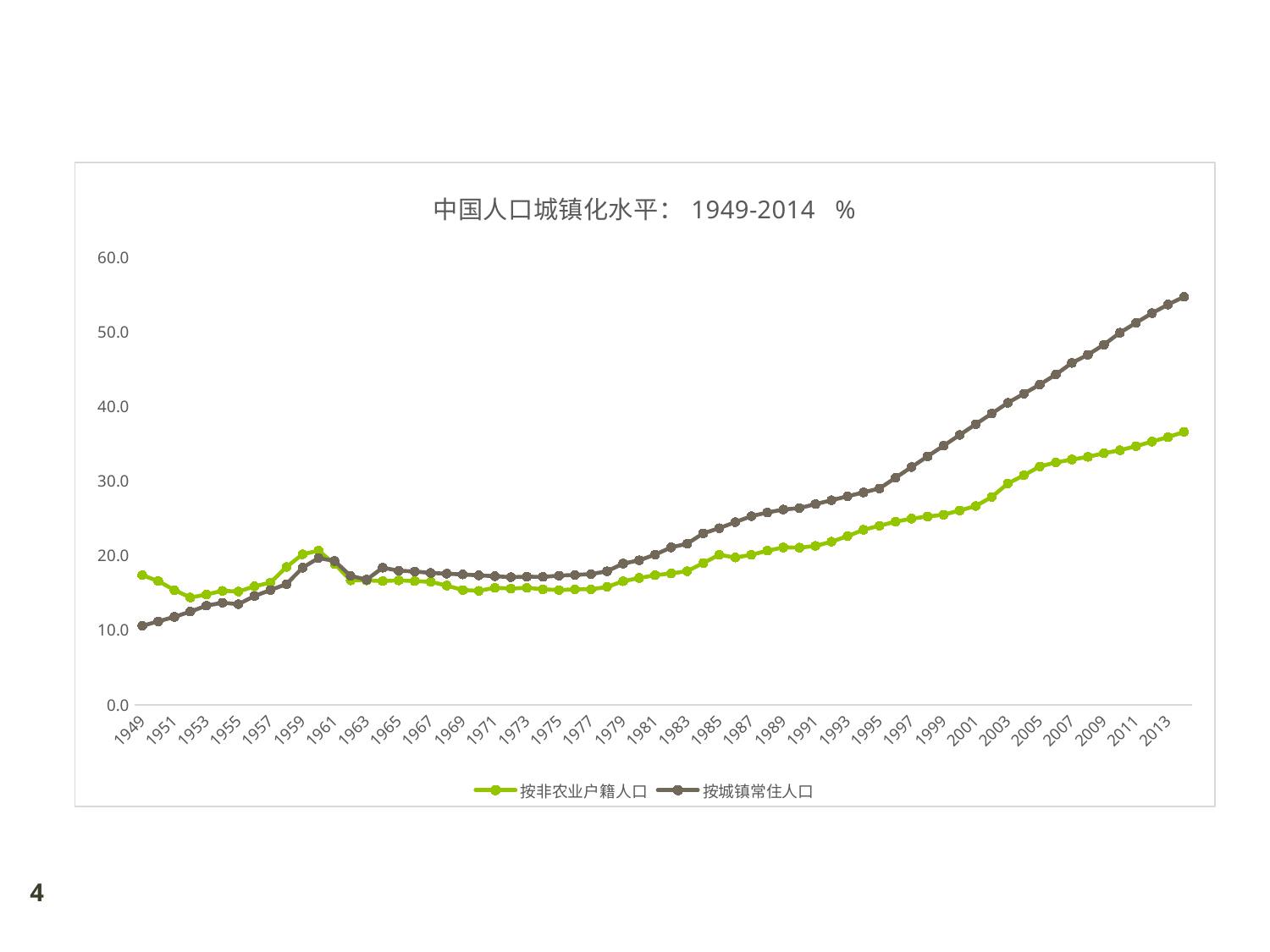
Is the value for 按非农业户籍人口 in 2013 greater or less than 40.0? less In which year does the 按城镇常住人口 series reach its lowest value? 1949 Is the value for 按城镇常住人口 in 1949 greater or less than 20.0? less In 1949, which series has the larger value, 按非农业户籍人口 or 按城镇常住人口? 按非农业户籍人口 Is the value for 按城镇常住人口 in 2013 greater or less than 50.0? greater What is the title of the chart? 中国人口城镇化水平： 1949-2014 % Does the 按城镇常住人口 series generally rise or fall from 1979 to 2013? rise What kind of chart is shown on the slide? line chart Which series is drawn in green? 按非农业户籍人口 In 2013, which series has the larger value, 按非农业户籍人口 or 按城镇常住人口? 按城镇常住人口 How many series does the legend list? 2